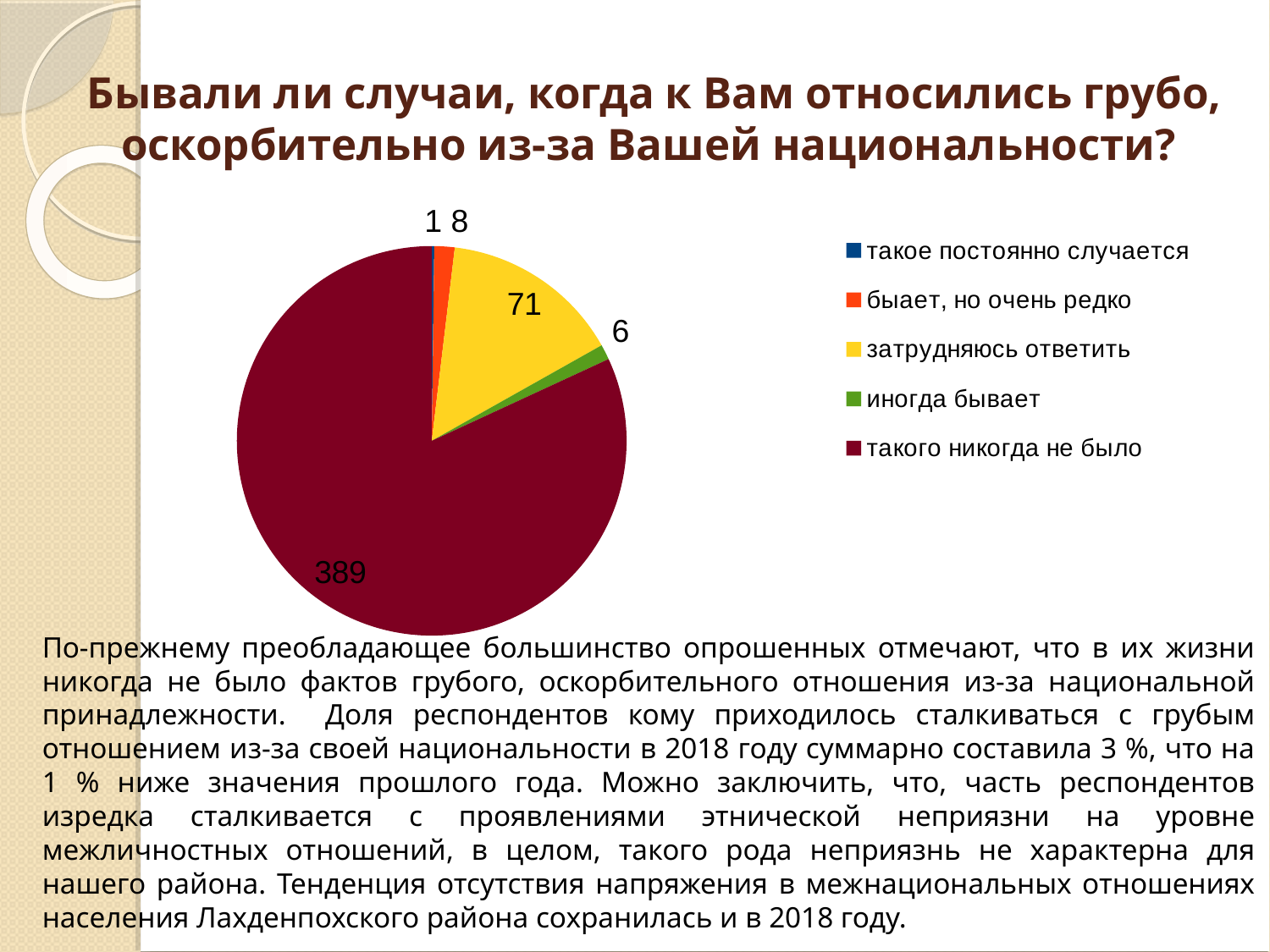
How many categories does the legend of the pie chart list? 5 Which category has the largest slice of the pie? такого никогда не было Which is larger, the value for "бывает, но очень редко" or the value for "иногда бывает"? бывает, но очень редко What is the value for "бывает, но очень редко"? 8 What type of chart is shown on the slide? pie chart What colour is the slice for "затрудняюсь ответить"? yellow What is the value for "такого никогда не было"? 389 What is the value for "затрудняюсь ответить"? 71 What is the difference between the values for "такого никогда не было" and "затрудняюсь ответить"? 318 What is the value for "иногда бывает"? 6 Which category has the smallest slice of the pie? такое постоянно случается What is the value for "такое постоянно случается"? 1